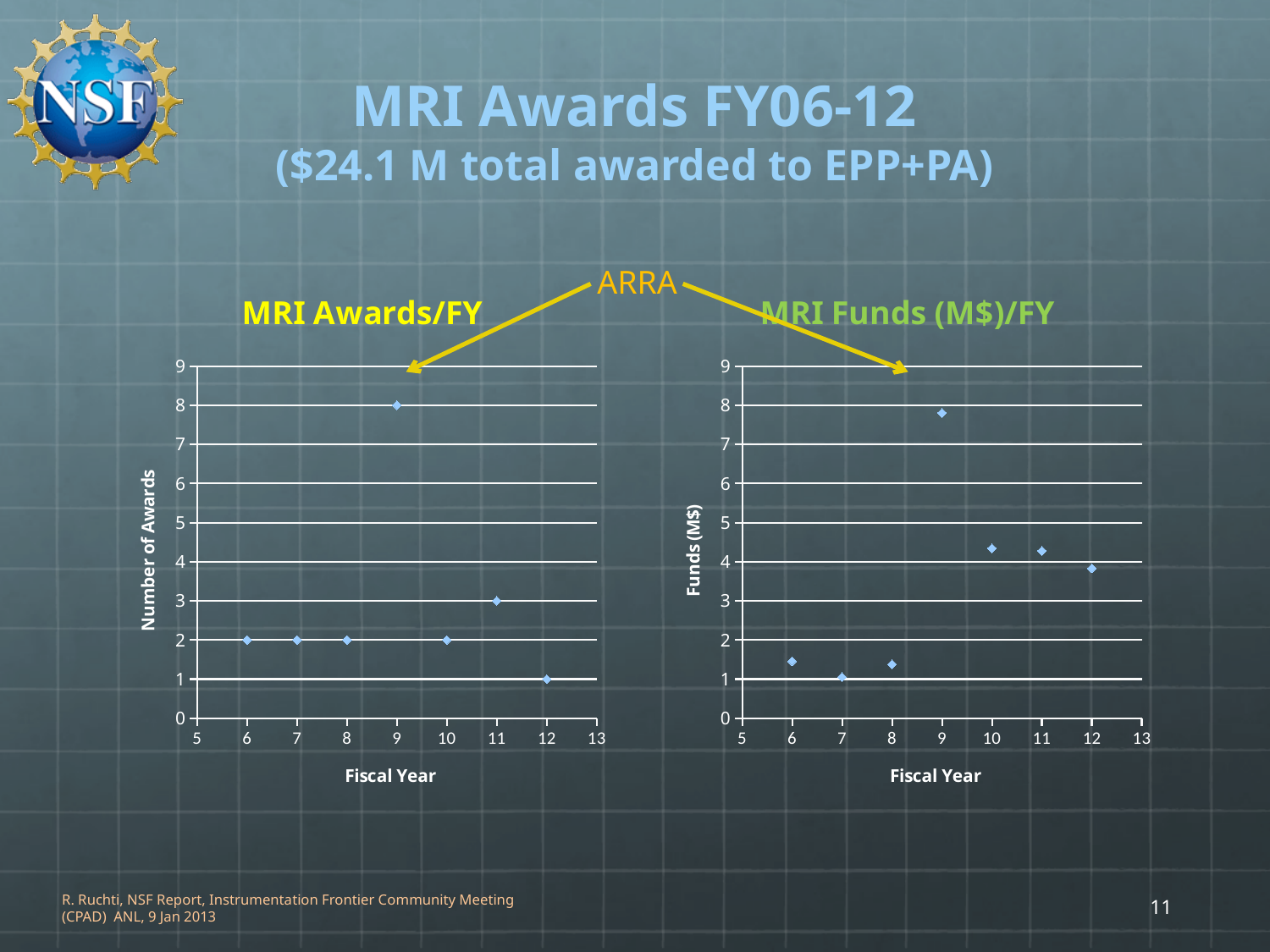
On the MRI Awards/FY chart, what is the difference in number of awards between fiscal year 9 and fiscal year 11? 5 On the MRI Awards/FY chart, what is the number of awards for fiscal year 11? 3 On the MRI Awards/FY chart, what is the number of awards for fiscal year 9? 8 What kind of chart is the MRI Funds (M$)/FY chart? scatter chart On the MRI Funds (M$)/FY chart, is the value for fiscal year 7 greater or less than 2? less On the MRI Awards/FY chart, which fiscal year has the highest number of awards? 9 On the MRI Awards/FY chart, what is the number of awards for fiscal year 12? 1 On the MRI Funds (M$)/FY chart, is the value for fiscal year 9 greater or less than 7? greater On the MRI Awards/FY chart, which fiscal year has the lowest number of awards? 12 On the MRI Funds (M$)/FY chart, which fiscal year has the highest funds? 9 On the MRI Awards/FY chart, how many fiscal years have data points plotted? 7 On the MRI Funds (M$)/FY chart, which is larger, the value for fiscal year 10 or the value for fiscal year 12? fiscal year 10